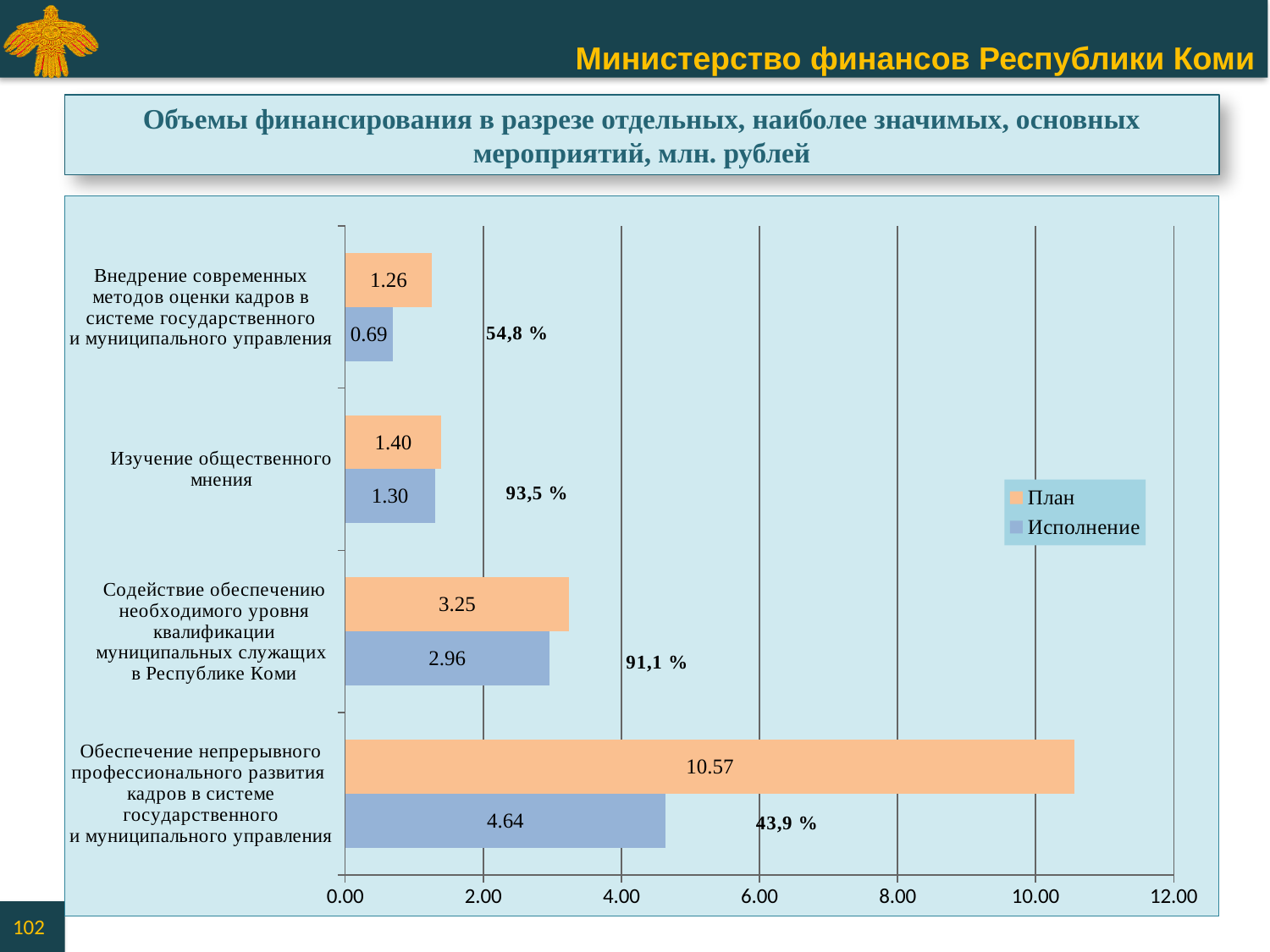
Is the План value for "Обеспечение непрерывного профессионального развития кадров в системе государственного и муниципального управления" greater or less than 10.00? greater What is the План value for "Изучение общественного мнения"? 1.40 What is the Исполнение value for "Внедрение современных методов оценки кадров в системе государственного и муниципального управления"? 0.69 Which category has the lowest Исполнение value? Внедрение современных методов оценки кадров в системе государственного и муниципального управления What is the Исполнение value for "Обеспечение непрерывного профессионального развития кадров в системе государственного и муниципального управления"? 4.64 How many categories are shown on the chart? 4 What percentage is shown next to the bars for "Содействие обеспечению необходимого уровня квалификации муниципальных служащих в Республике Коми"? 91,1 % How many series does the legend list? 2 Which category has the highest План value? Обеспечение непрерывного профессионального развития кадров в системе государственного и муниципального управления What is the difference between the План and Исполнение values for "Обеспечение непрерывного профессионального развития кадров в системе государственного и муниципального управления"? 5.93 Which is larger: the План value for "Содействие обеспечению необходимого уровня квалификации муниципальных служащих в Республике Коми" or the Исполнение value for the same category? План (3.25) What type of chart is shown on the slide? Bar chart